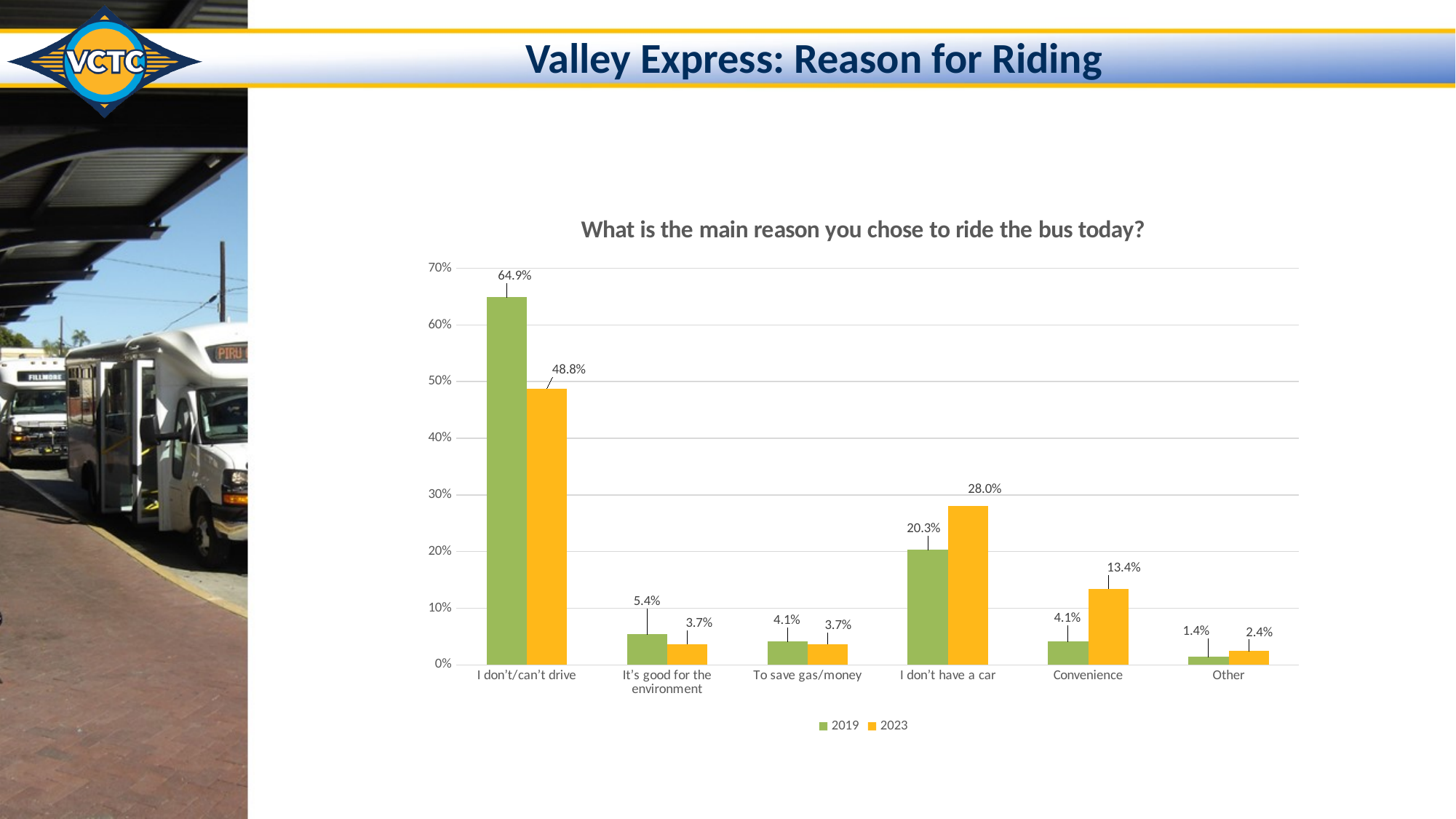
What is the 2019 value for "I don't/can't drive"? 64.9% What kind of chart is shown on the slide? bar chart Is the 2023 value for "I don't/can't drive" greater or less than 50%? less What is the 2023 value for "I don't have a car"? 28.0% How many series does the legend list? 2 What is the title of the chart? What is the main reason you chose to ride the bus today? Which category has the lowest 2019 value? Other How many categories are shown on the x axis? 6 What is the difference between the 2019 and 2023 values for "I don't/can't drive"? 16.1% What is the 2023 value for Convenience? 13.4% Which is larger for Convenience, the 2019 value or the 2023 value? 2023 Which category has the highest 2023 value? I don't/can't drive